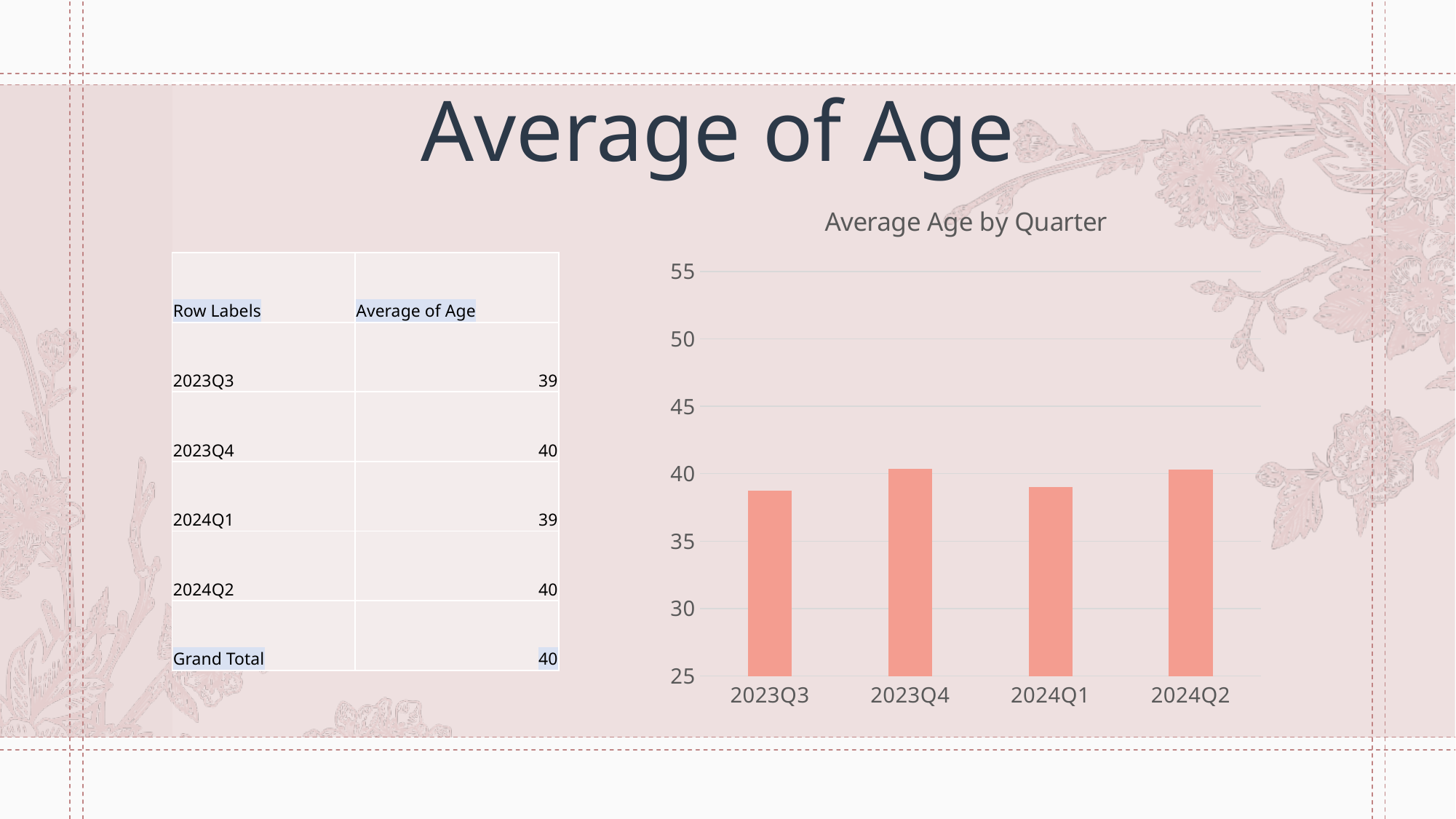
How many quarters are plotted in the chart? 4 Is the value for 2023Q3 greater or less than 40? less Does the value rise or fall from 2023Q4 to 2024Q1? fall Is the value for 2023Q4 greater or less than 45? less Which has the larger value, 2024Q1 or 2024Q2? 2024Q2 Which has the larger value, 2023Q3 or 2023Q4? 2023Q4 Does the value rise or fall from 2023Q3 to 2023Q4? rise Is the value for 2024Q1 greater or less than 40? less What is the title of the chart? Average Age by Quarter What kind of chart is shown on the slide? bar chart What is the lowest value shown on the chart's vertical axis? 25